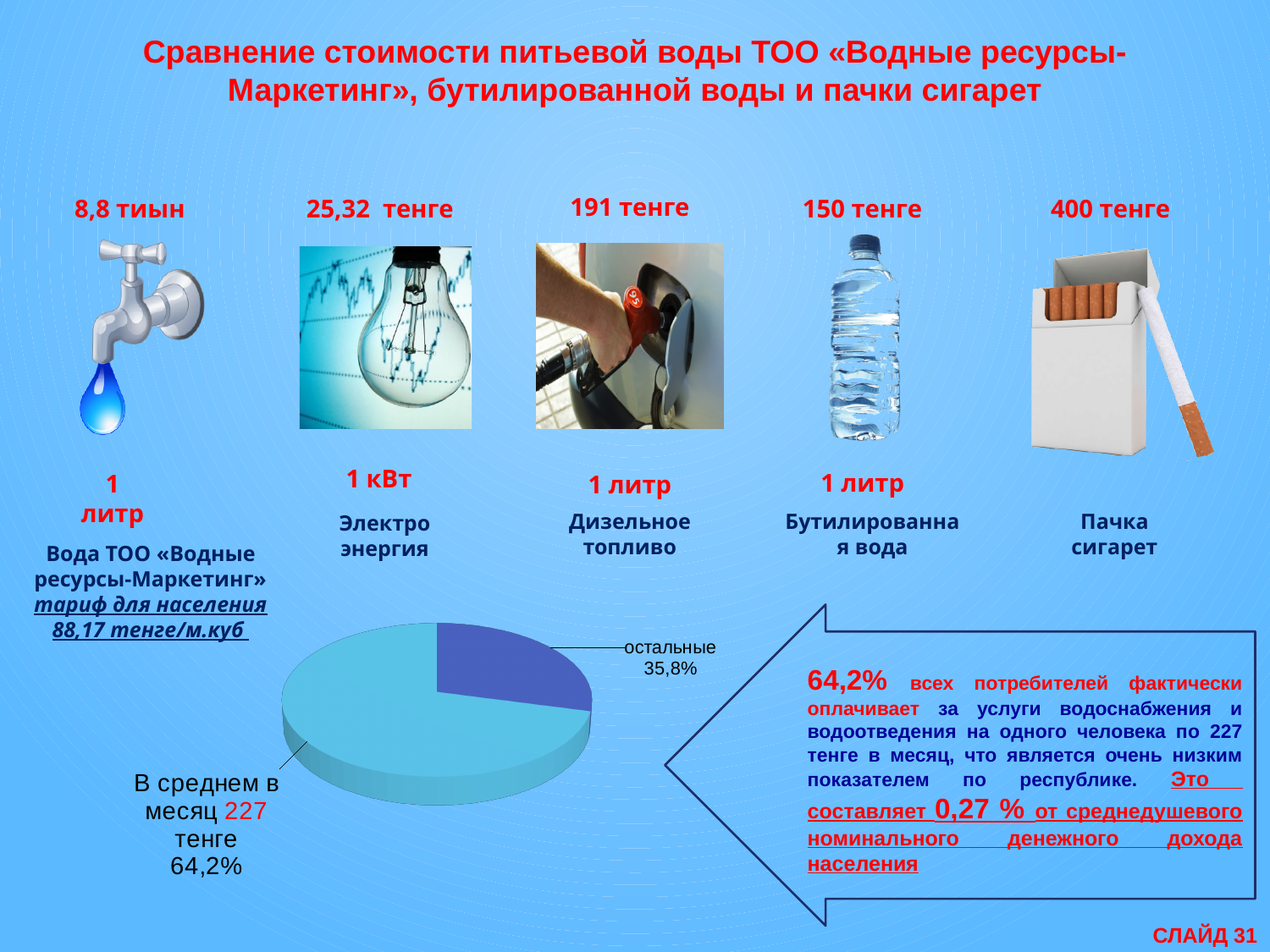
What percentage is shown for the slice labelled "В среднем в месяц 227 тенге"? 64,2% What colour is the "остальные" slice in the pie chart? dark blue By how many percentage points does the 64,2% slice exceed the "остальные" slice? 28,4 How many slices does the pie chart have? 2 Which is larger in the pie chart: the "остальные" slice or the "В среднем в месяц 227 тенге" slice? В среднем в месяц 227 тенге What do the two slices of the pie chart add up to? 100% What share of the pie chart is labelled "остальные"? 35,8% What kind of chart is shown at the bottom left of the slide? pie chart Which slice of the pie chart is the smallest? остальные (35,8%) What colour is the larger slice of the pie chart? light blue Which slice of the pie chart is the largest? В среднем в месяц 227 тенге (64,2%) Is the "остальные" slice greater or less than half of the pie? less